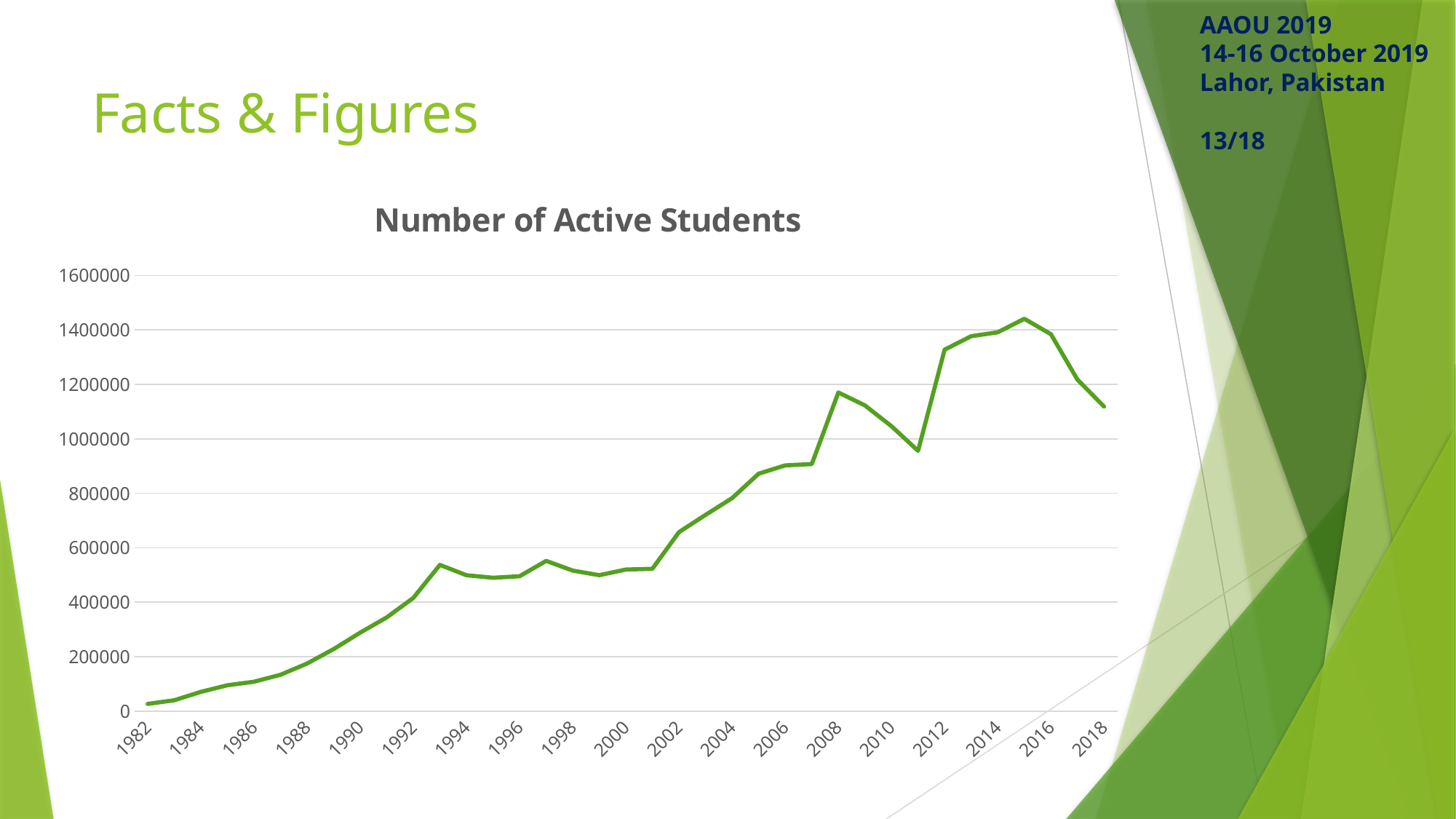
Does the number of active students rise or fall between 2016 and 2018? fall Does the number of active students rise or fall between 1982 and 1992? rise Is the highest point on the line greater or less than 1400000? greater What is the title of the chart? Number of Active Students Is the number of active students in 2018 greater or less than 1200000? less Is the number of active students in 2012 greater or less than 1200000? greater What kind of chart is shown on the slide? line chart Which year on the x axis has the lowest number of active students? 1982